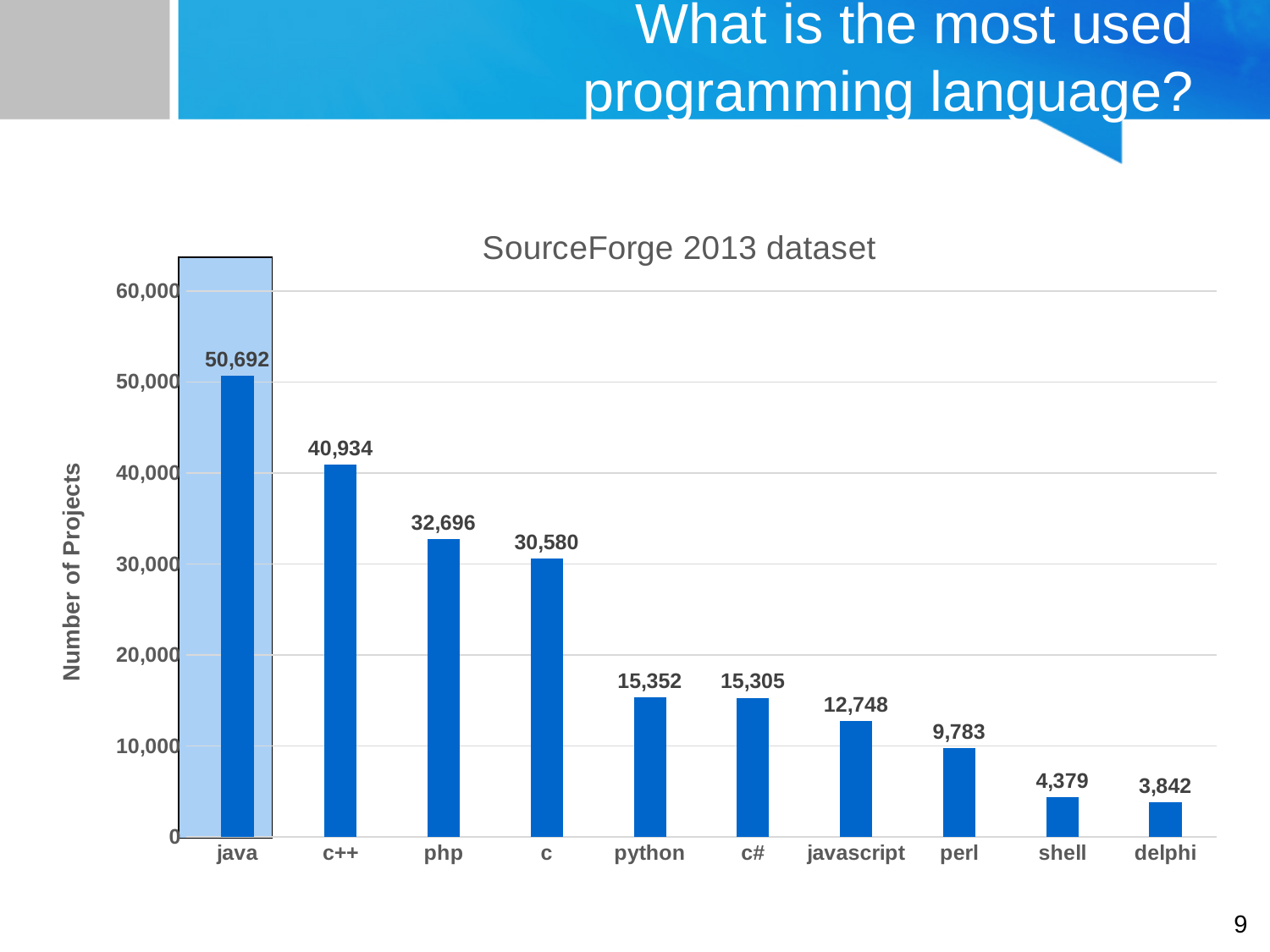
What kind of chart is shown on the slide? bar chart Which programming language has the lowest number of projects? delphi Which has more projects, php or c? php What is the difference in number of projects between shell and delphi? 537 What is the number of projects for javascript? 12,748 What is the title of the chart? SourceForge 2013 dataset What is the difference in number of projects between java and c++? 9,758 Is the number of projects for c# greater or less than 20,000? less Which programming language has the highest number of projects? java What is the number of projects for perl? 9,783 What is the number of projects for java? 50,692 How many programming languages are shown on the chart? 10